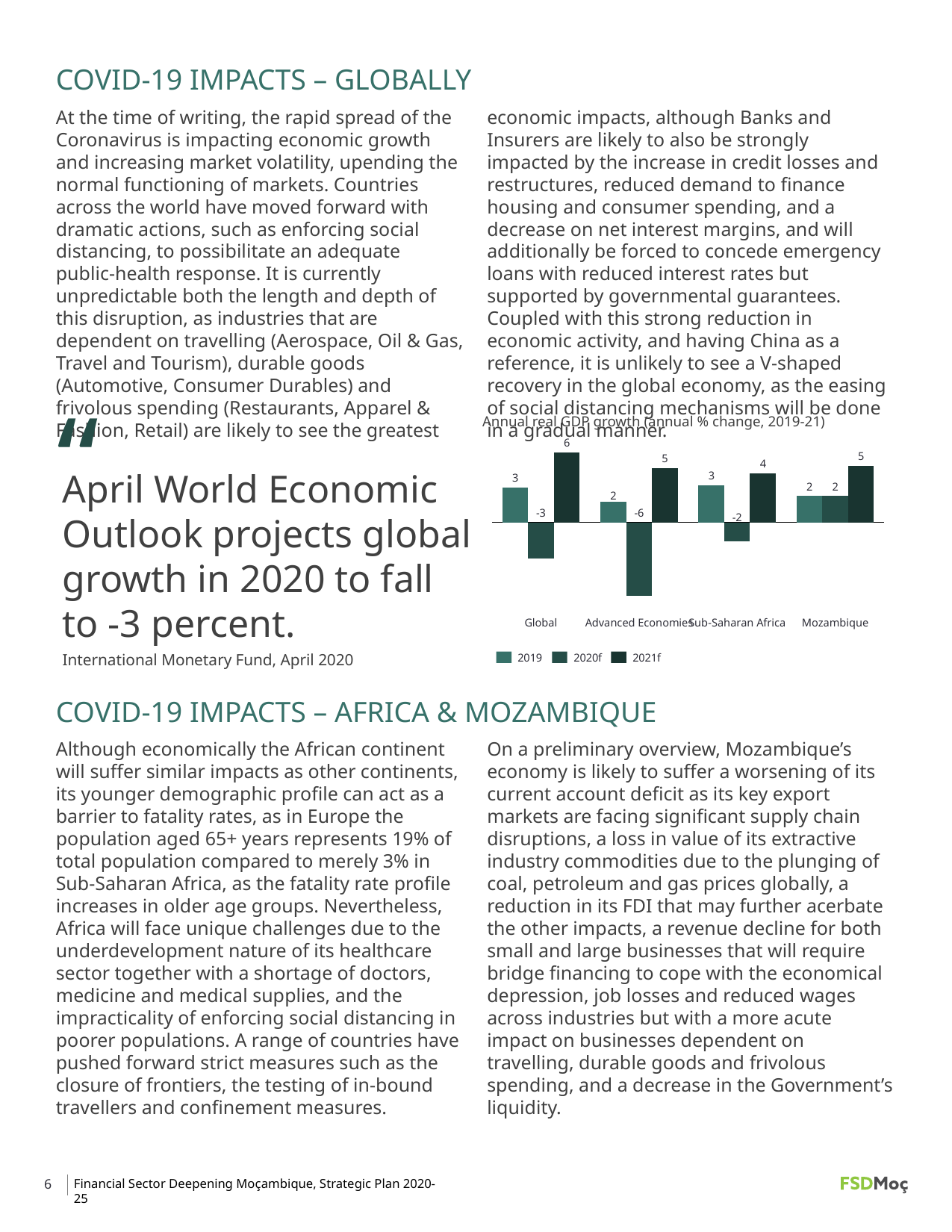
Which category has the highest 2021f value? Global What kind of chart is shown? bar chart How many series does the legend list? 3 What is the 2020f value for Mozambique? 2 What is the difference between the 2021f and 2020f values for Global? 9 Which category has the lowest 2020f value? Advanced Economies How many categories are shown on the x axis? 4 What is the title of the chart? Annual real GDP growth (annual % change, 2019-21) What is the 2020f value for Advanced Economies? -6 Is the 2020f value for Mozambique larger or smaller than the 2020f value for Sub-Saharan Africa? larger What is the 2021f value for Global? 6 What is the 2019 value for Sub-Saharan Africa? 3